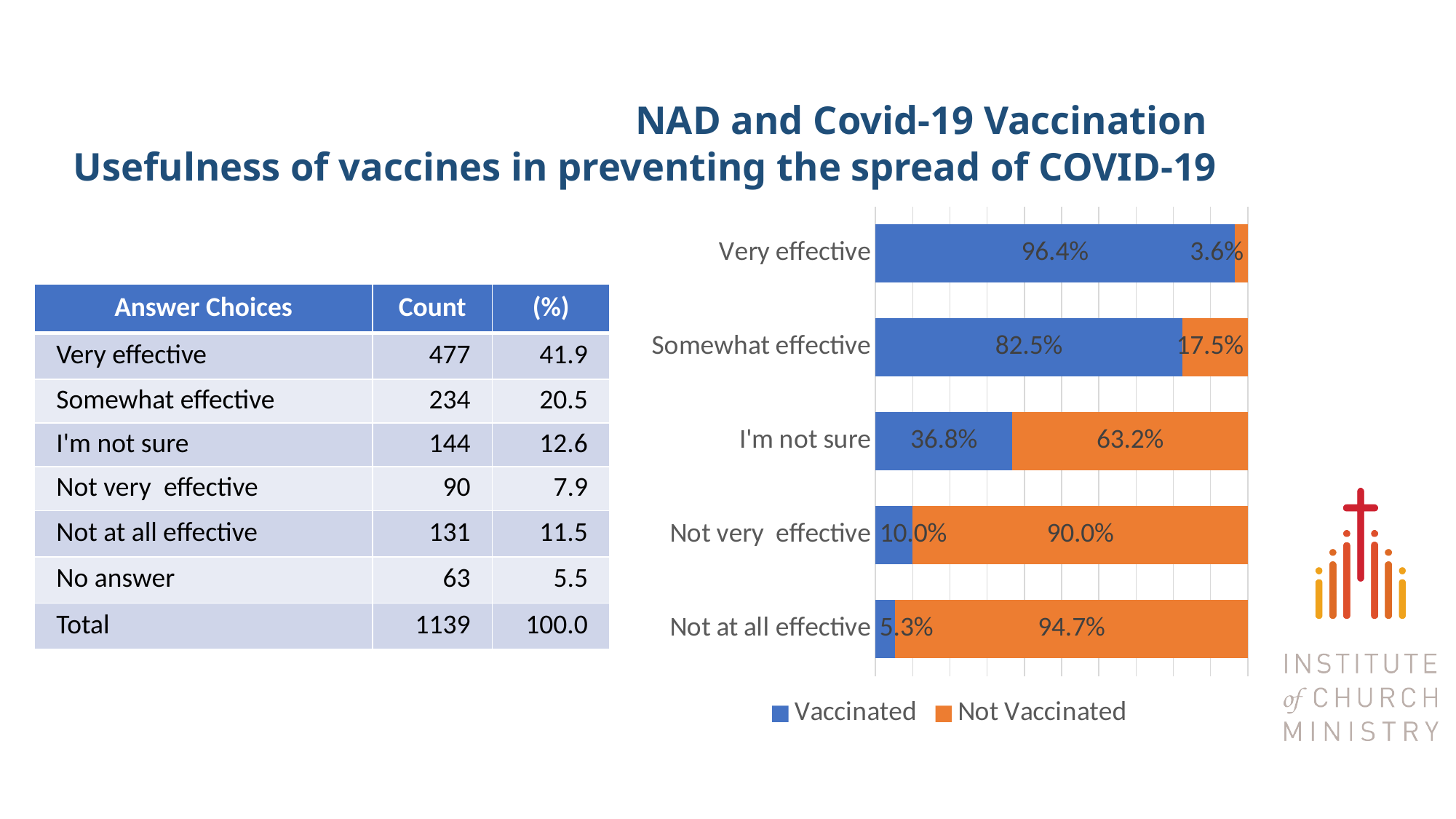
How many categories are shown in the chart? 5 Which is larger: the Vaccinated value for 'I'm not sure' or the Vaccinated value for 'Not very effective'? I'm not sure What kind of chart is shown on the slide? Stacked bar chart What is the Vaccinated value for 'Not at all effective'? 5.3% Which category has the highest Vaccinated value? Very effective What is the difference between the Not Vaccinated values for 'Not very effective' and 'Not at all effective'? 4.7% What is the Not Vaccinated value for 'Somewhat effective'? 17.5% Which colour represents the Not Vaccinated series? Orange What is the Not Vaccinated value for 'I'm not sure'? 63.2% How many series does the legend list? 2 What is the Vaccinated value for 'Very effective'? 96.4% Which category has the lowest Not Vaccinated value? Very effective